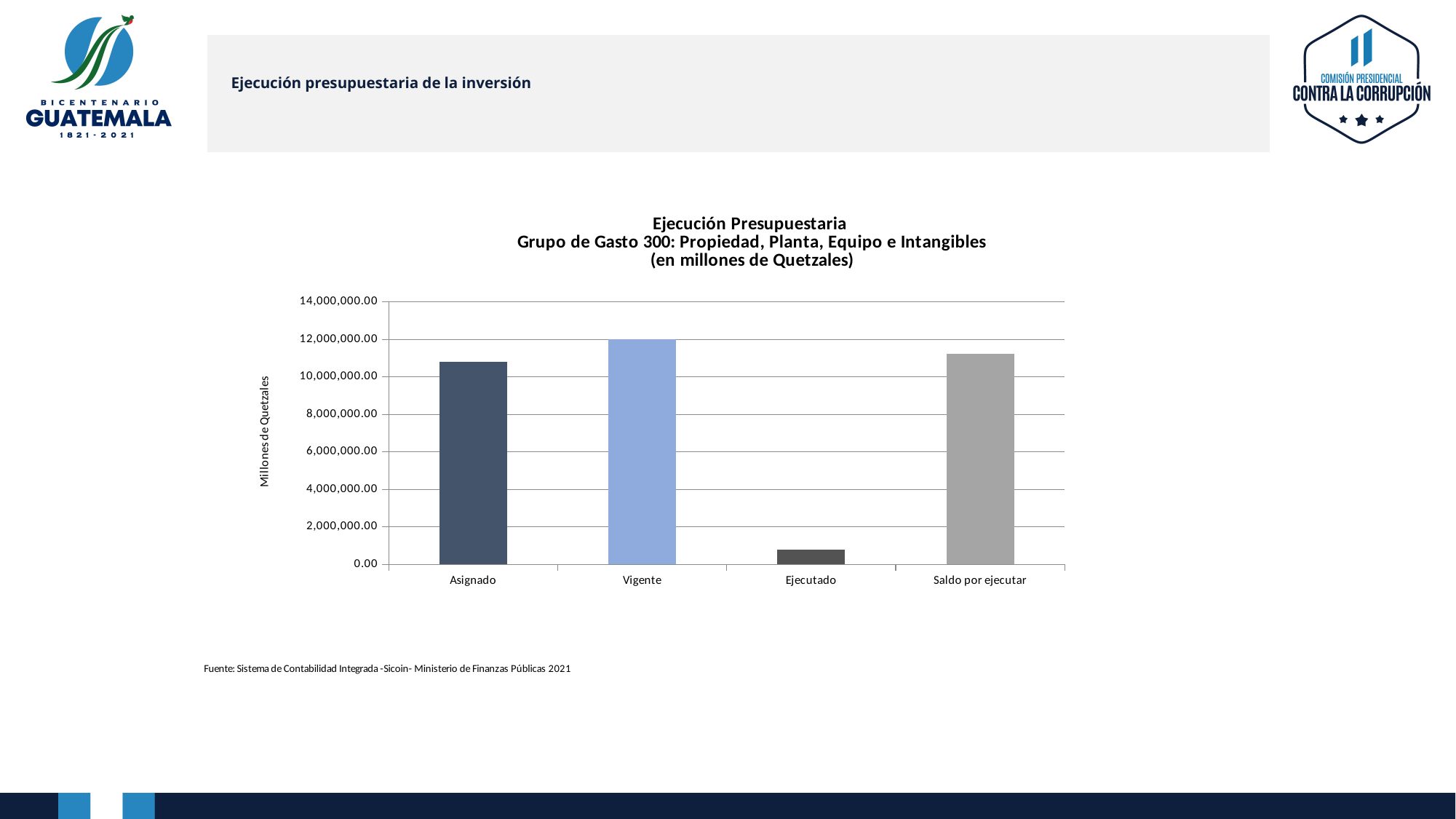
Which expense group does the chart title say it covers? Grupo de Gasto 300: Propiedad, Planta, Equipo e Intangibles Which category has the lowest value in the chart? Ejecutado Is the value for Ejecutado greater or less than 2,000,000.00? less Is the value for Saldo por ejecutar greater or less than 12,000,000.00? less Which is larger, the value for Ejecutado or the value for Saldo por ejecutar? Saldo por ejecutar Which is larger, the value for Vigente or the value for Asignado? Vigente How many categories are shown on the x axis of the chart? 4 What kind of chart is shown on the slide? bar chart Which category has the highest value in the chart? Vigente Is the value for Asignado greater or less than 10,000,000.00? greater What is the label of the vertical axis of the chart? Millones de Quetzales